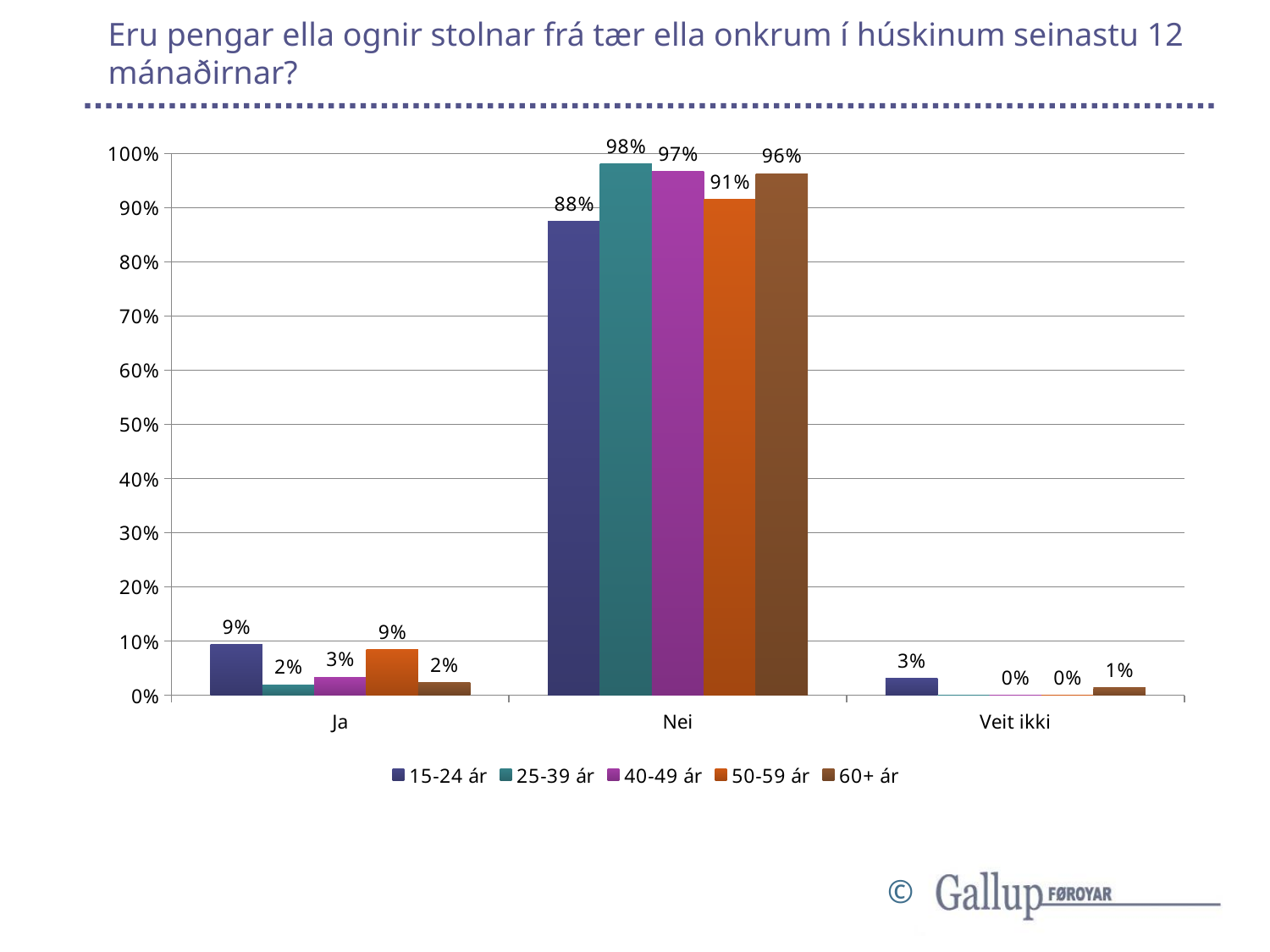
What is the value for the 25-39 ár series in the Nei category? 98% Which age group has the lowest value in the Nei category? 15-24 ár Which age group has the highest value in the Nei category? 25-39 ár What is the value for the 60+ ár series in the Veit ikki category? 1% How many series does the legend list? 5 What is the value for the 15-24 ár series in the Ja category? 9% Is the value for 15-24 ár in the Nei category greater or less than 90%? less How many categories are shown on the x axis? 3 What is the value for the 50-59 ár series in the Nei category? 91% In the Ja category, which is larger: the value for 40-49 ár or the value for 50-59 ár? 50-59 ár What is the difference between the 25-39 ár and 15-24 ár values in the Nei category? 10% What kind of chart is shown on the slide? bar chart